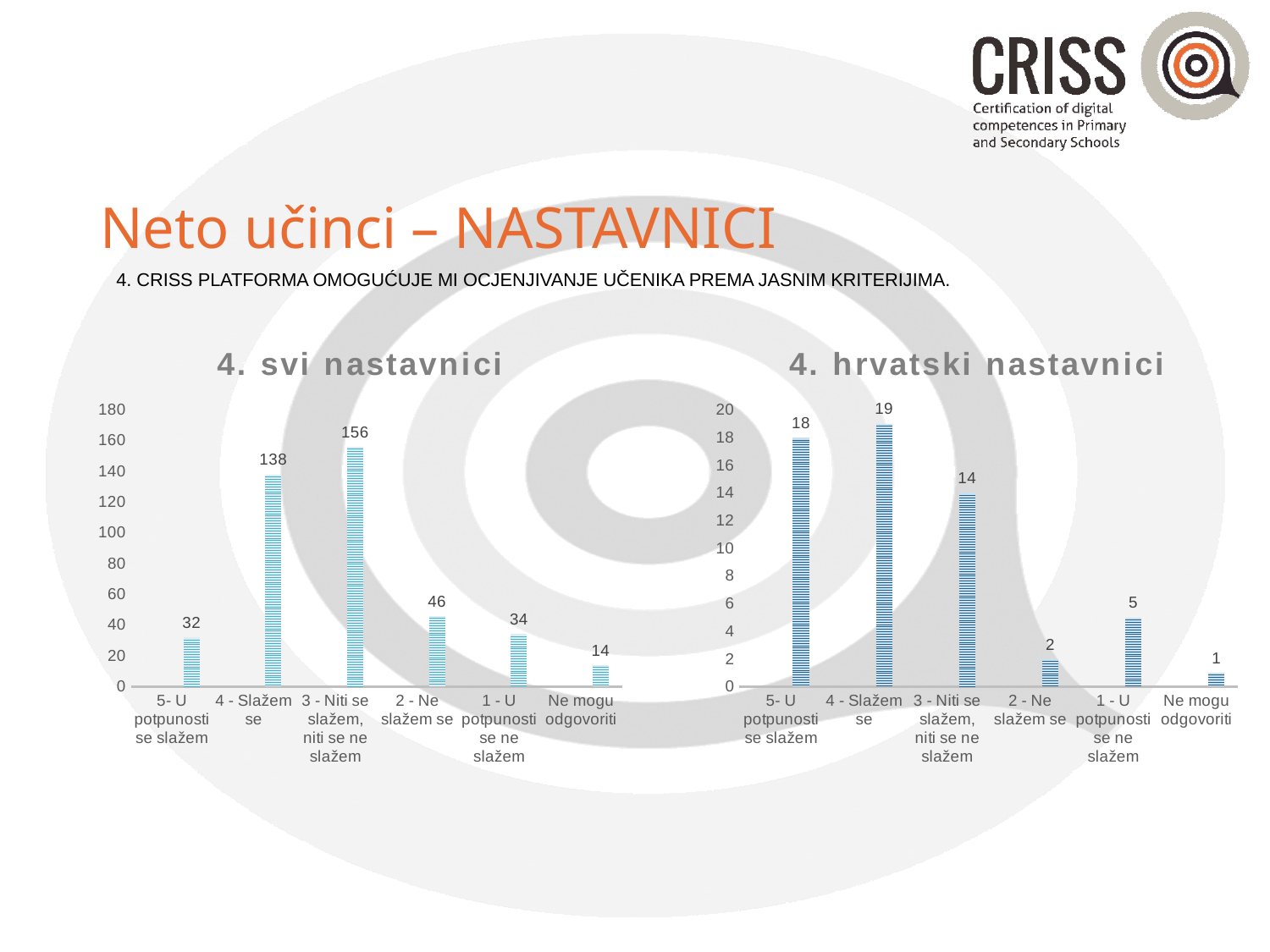
In the chart titled "4. svi nastavnici", what is the difference between the values for "3 - Niti se slažem, niti se ne slažem" and "4 - Slažem se"? 18 In the chart titled "4. hrvatski nastavnici", what is the value for "4 - Slažem se"? 19 In the chart titled "4. hrvatski nastavnici", which category has the highest value? 4 - Slažem se In the chart titled "4. svi nastavnici", what is the value for "5- U potpunosti se slažem"? 32 In the chart titled "4. svi nastavnici", what is the value for "3 - Niti se slažem, niti se ne slažem"? 156 In the chart titled "4. svi nastavnici", how many categories are shown on the x axis? 6 In the chart titled "4. hrvatski nastavnici", what is the value for "Ne mogu odgovoriti"? 1 How many charts are shown on the slide? 2 In the chart titled "4. svi nastavnici", which is larger: the value for "2 - Ne slažem se" or the value for "1 - U potpunosti se ne slažem"? 2 - Ne slažem se What kind of chart is the chart titled "4. svi nastavnici"? Bar chart In the chart titled "4. hrvatski nastavnici", what is the difference between the values for "5- U potpunosti se slažem" and "3 - Niti se slažem, niti se ne slažem"? 4 In the chart titled "4. svi nastavnici", which category has the lowest value? Ne mogu odgovoriti